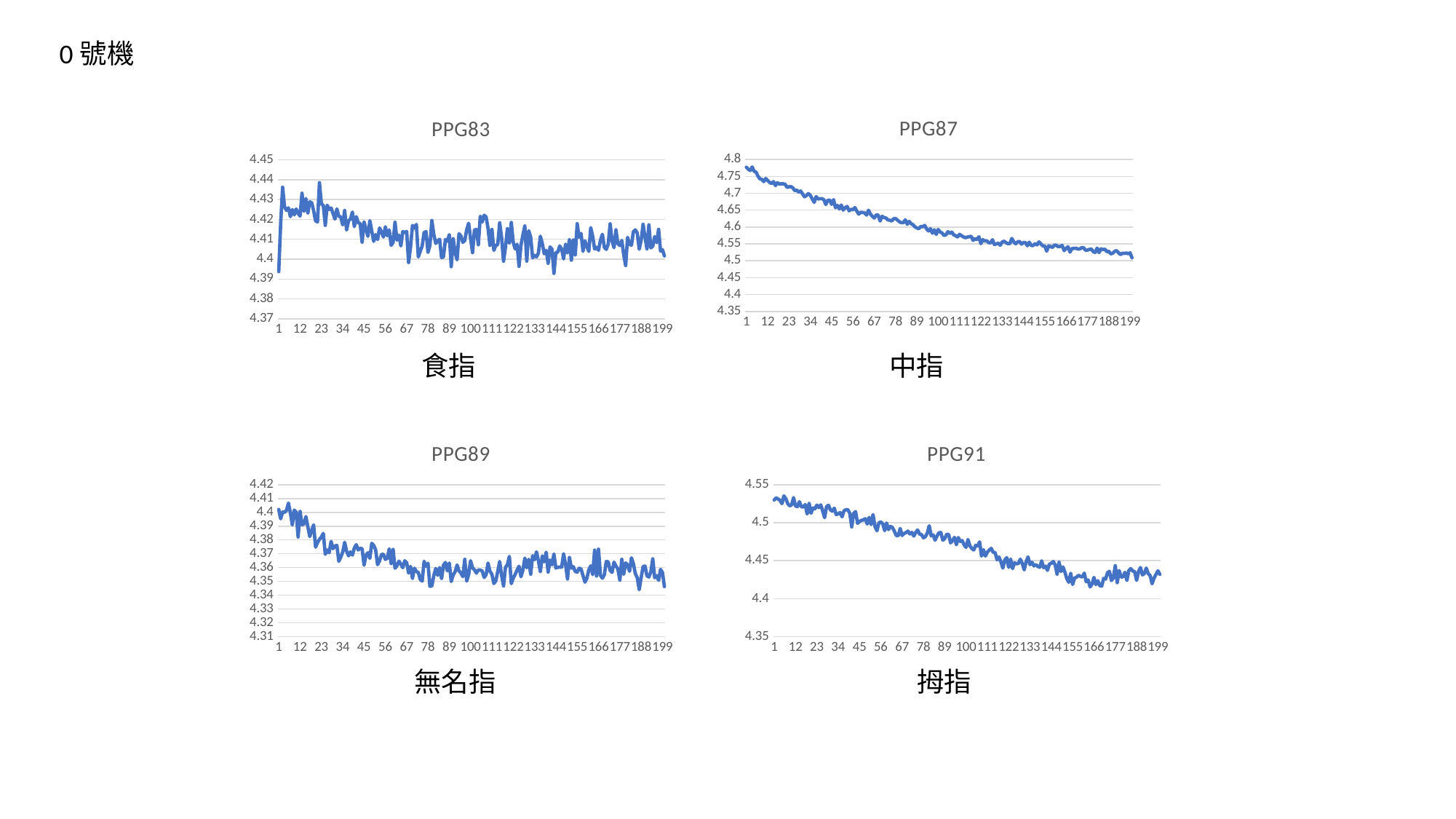
In the PPG91 chart, do the values generally rise or fall along the x axis? fall In the PPG91 chart, is the value at point 1 greater or less than 4.5? greater What is the title of the chart labelled 中指? PPG87 In the PPG87 chart, do the values generally rise or fall along the x axis? fall In the PPG83 chart, is the value at point 199 greater or less than 4.42? less In the PPG87 chart, is the value at point 1 greater or less than 4.7? greater What kind of chart is PPG83? line chart How many charts are shown on the slide? 4 In the PPG89 chart, do the values generally rise or fall along the x axis? fall